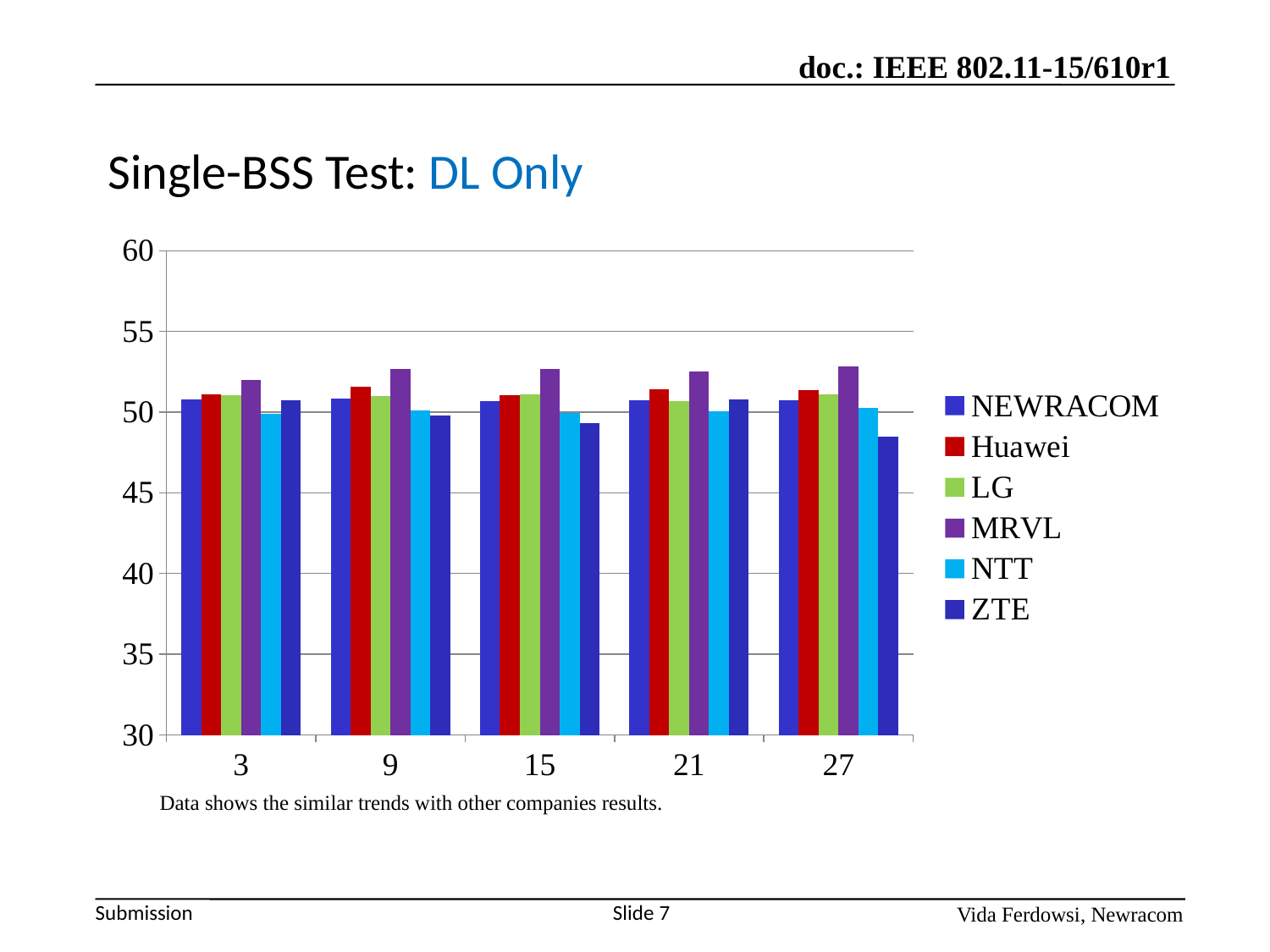
What is the title of the slide containing the chart? Single-BSS Test: DL Only What kind of chart is shown on the slide? bar chart How many series does the legend list? 6 How many categories are shown along the x axis? 5 Is the value for MRVL at category 9 greater or less than 50? greater Which series has the highest value at category 15? MRVL Which is larger at category 15, the value for MRVL or the value for ZTE? MRVL Is the value for Huawei at category 21 greater or less than 55? less Is the value for ZTE at category 27 greater or less than 50? less Which series has the lowest value at category 27? ZTE Which series is shown in the legend immediately after Huawei? LG Which series has the highest value at category 27? MRVL